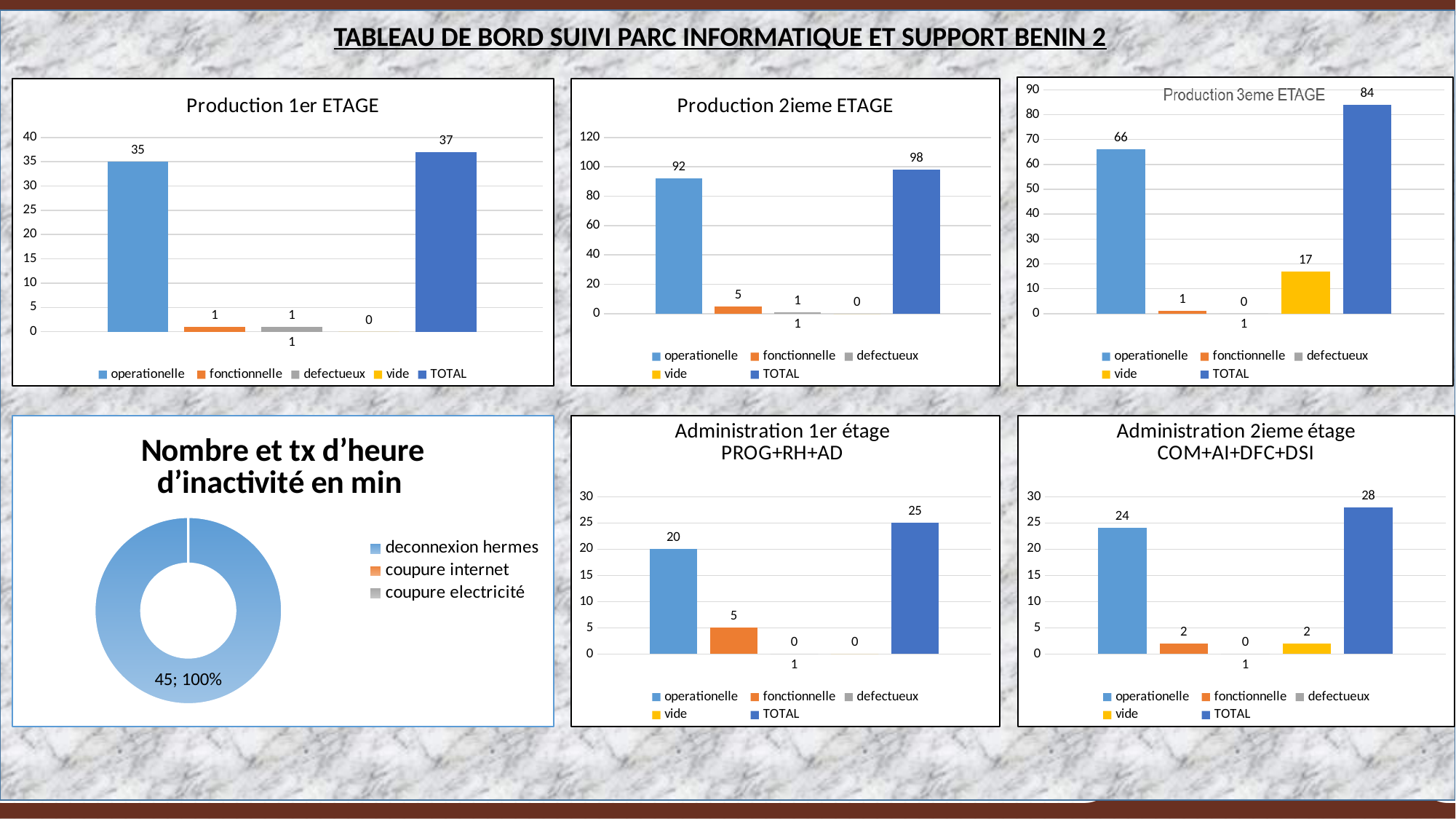
What kind of chart is the Nombre et tx d'heure d'inactivité en min chart? Doughnut chart In the Production 3eme ETAGE chart, what is the value for vide? 17 In the Production 1er ETAGE chart, what is the value for operationelle? 35 In the Production 3eme ETAGE chart, what is the difference between TOTAL and operationelle? 18 In the Administration 2ieme étage COM+AI+DFC+DSI chart, which is larger, operationelle or TOTAL? TOTAL In the Administration 2ieme étage COM+AI+DFC+DSI chart, what is the difference between TOTAL and operationelle? 4 How many entries does the legend of the Nombre et tx d'heure d'inactivité en min chart list? 3 In the Production 2ieme ETAGE chart, what is the value for TOTAL? 98 In the Administration 1er étage PROG+RH+AD chart, what is the value for fonctionnelle? 5 How many series does the legend of the Production 1er ETAGE chart list? 5 In the Nombre et tx d'heure d'inactivité en min chart, what share does the deconnexion hermes slice have? 100% In the Production 2ieme ETAGE chart, which series has the highest value? TOTAL